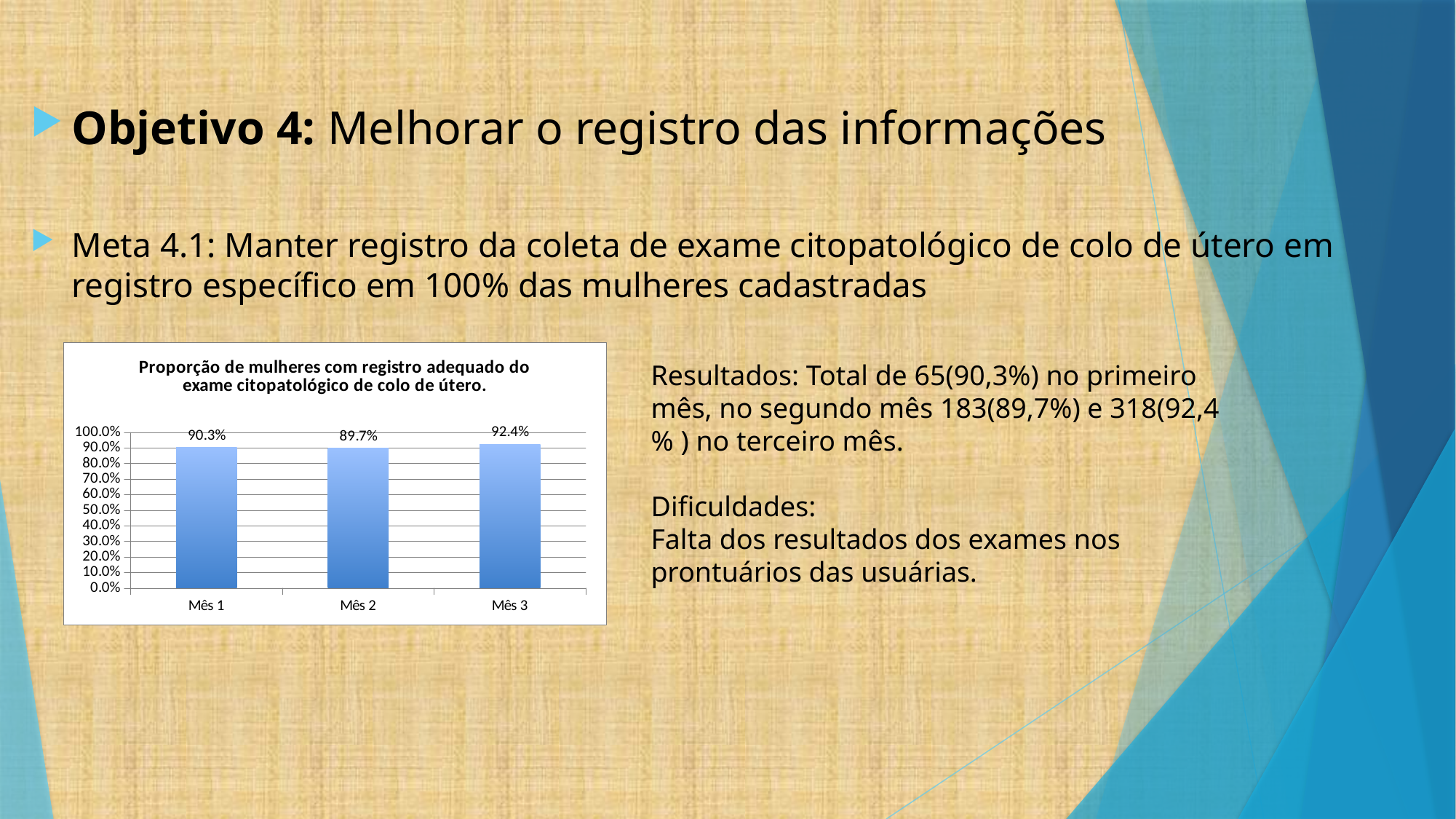
What is the title of the chart? Proporção de mulheres com registro adequado do exame citopatológico de colo de útero. What is the value for Mês 1? 90.3% What is the difference between the values for Mês 1 and Mês 2? 0.6% What is the value for Mês 3? 92.4% Which is larger, the value for Mês 3 or the value for Mês 2? Mês 3 Which month has the highest value? Mês 3 Which month has the lowest value? Mês 2 What kind of chart is shown on the slide? bar chart How many months are shown on the x axis? 3 What is the difference between the values for Mês 3 and Mês 1? 2.1% Is the value for Mês 2 greater or less than 50.0%? greater What is the value for Mês 2? 89.7%